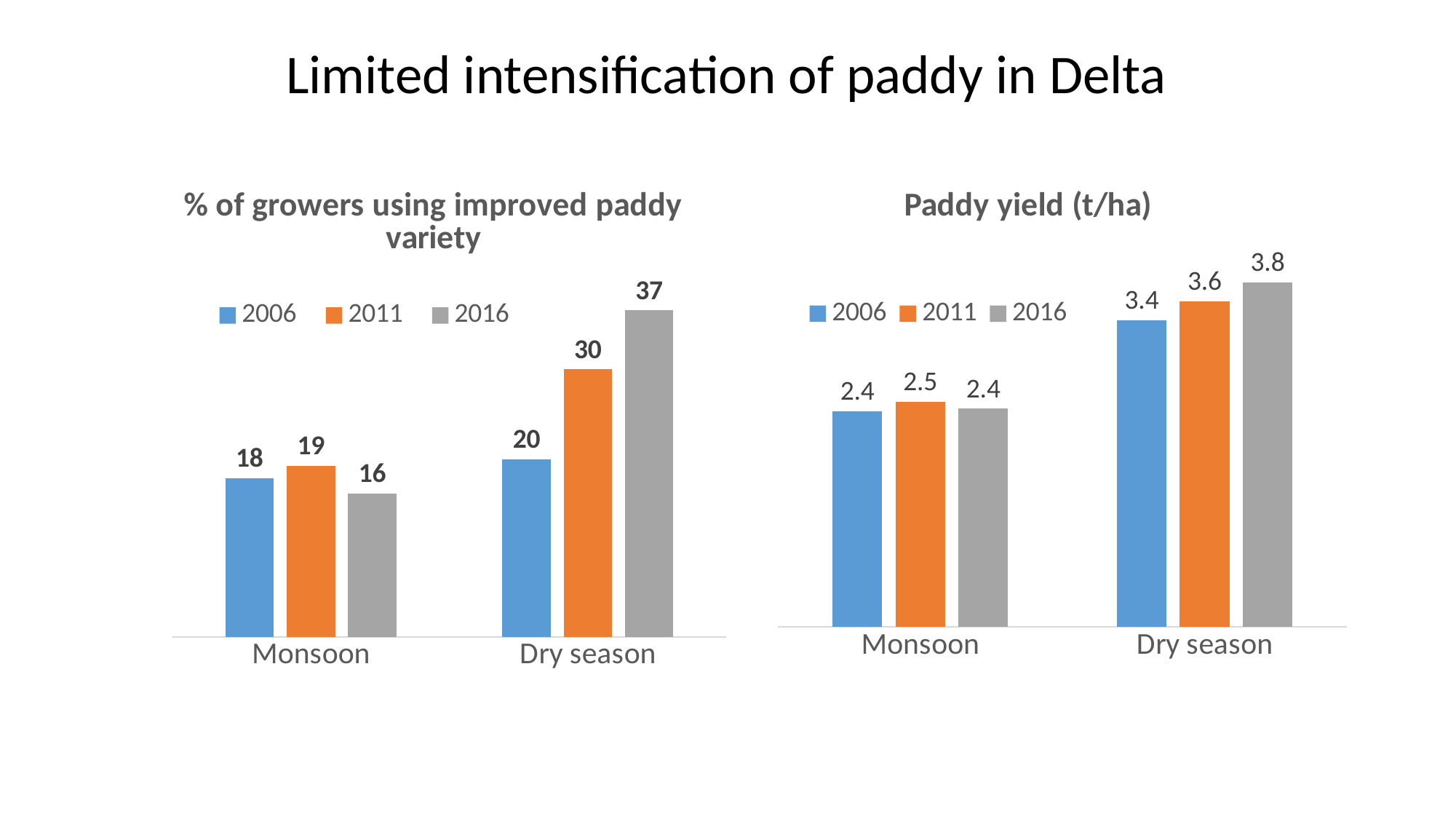
In the 'Paddy yield (t/ha)' chart, what is the difference between the 2016 Dry season yield and the 2006 Dry season yield? 0.4 In the '% of growers using improved paddy variety' chart, which year has the highest value in the Dry season? 2016 How many series does the legend list in the 'Paddy yield (t/ha)' chart? 3 In the 'Paddy yield (t/ha)' chart, what is the yield for 2011 in the Dry season? 3.6 In the '% of growers using improved paddy variety' chart, what is the value for 2016 in the Dry season? 37 In the '% of growers using improved paddy variety' chart, what is the difference between the 2016 Dry season value and the 2016 Monsoon value? 21 What kind of chart is the '% of growers using improved paddy variety' chart? Bar chart In the '% of growers using improved paddy variety' chart, which year has the lowest value in the Monsoon season? 2016 In the 'Paddy yield (t/ha)' chart, what is the yield for 2016 in the Monsoon season? 2.4 In the '% of growers using improved paddy variety' chart, what is the value for 2006 in the Monsoon season? 18 In the '% of growers using improved paddy variety' chart, do the Dry season values rise or fall from 2006 to 2016? Rise In the 'Paddy yield (t/ha)' chart, which is larger: the 2011 Monsoon yield or the 2006 Dry season yield? 2006 Dry season